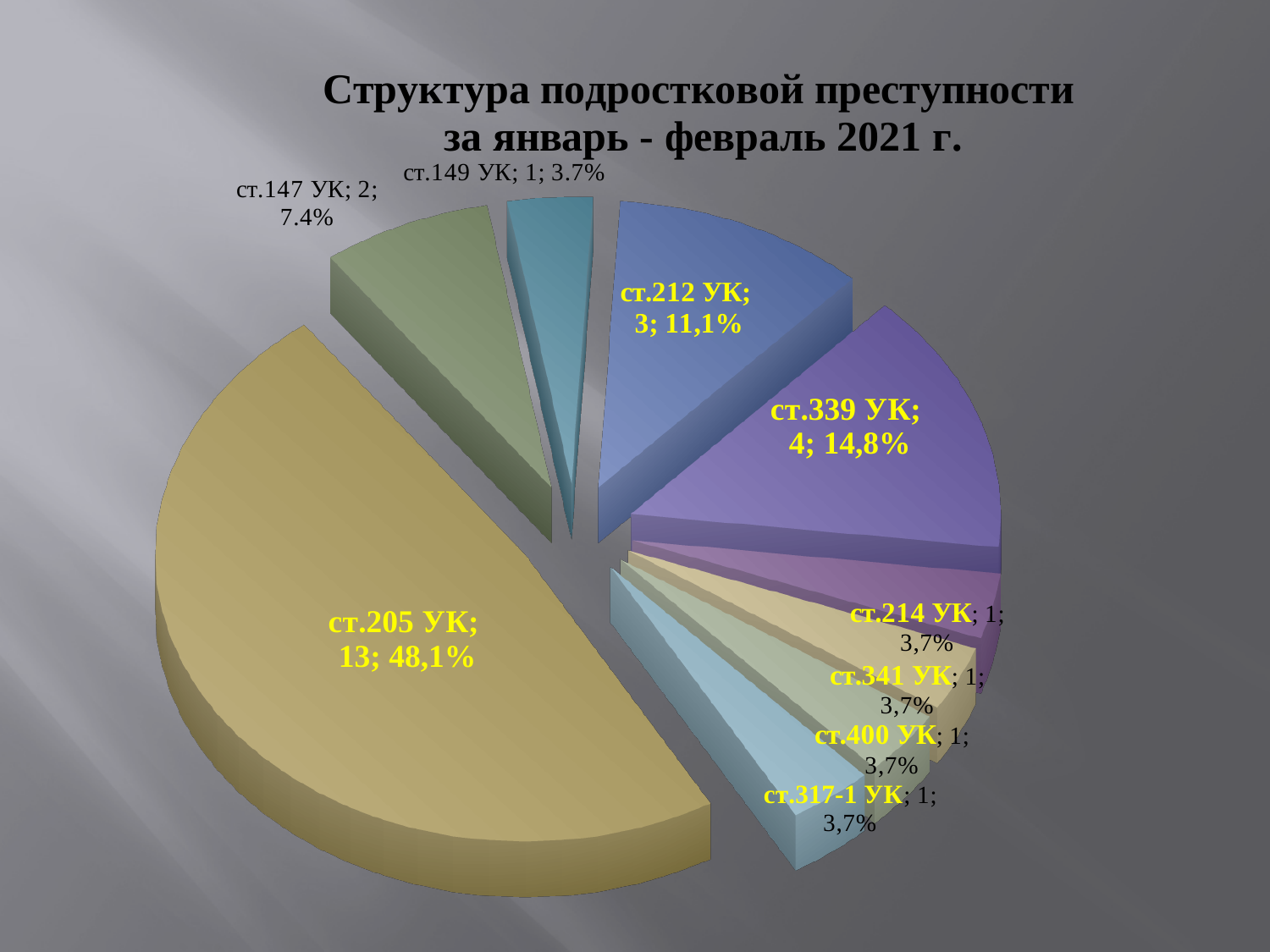
What is the value for ст.147 УК? 2 What is the value for ст.339 УК? 4 How many slices does the pie chart have? 9 Which category has the largest slice? ст.205 УК What kind of chart is shown on the slide? pie chart What is the value for ст.205 УК? 13 Which is larger, the value for ст.212 УК or the value for ст.147 УК? ст.212 УК What is the title of the chart? Структура подростковой преступности за январь - февраль 2021 г. What is the difference between the values for ст.205 УК and ст.339 УК? 9 What share of the pie does ст.212 УК represent? 11,1% What share of the pie does ст.214 УК represent? 3,7% What share of the pie does ст.205 УК represent? 48,1%